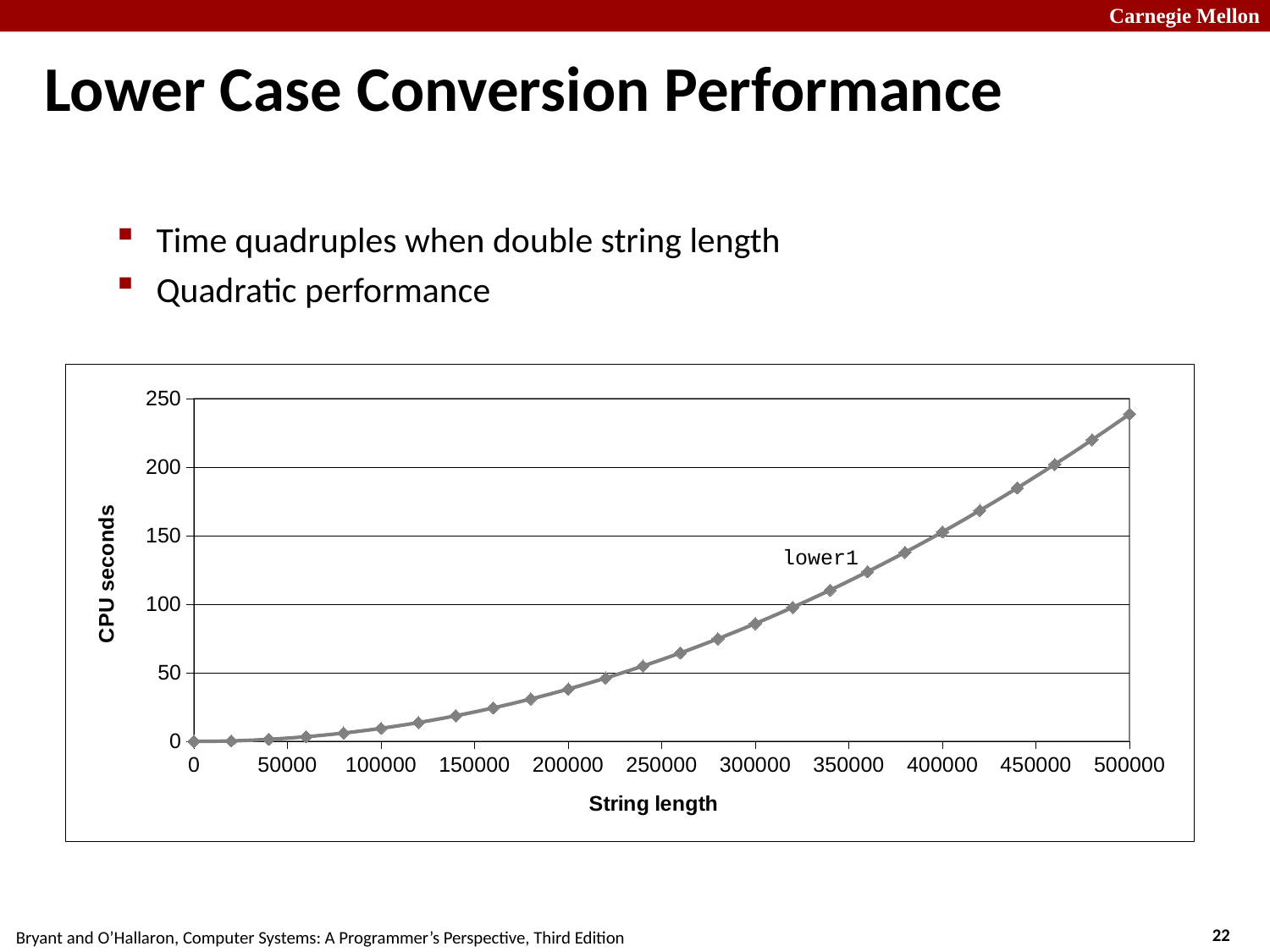
Do the CPU seconds rise or fall as string length increases? rise How many data points are plotted on the lower1 line? 26 Is the CPU seconds value at string length 500000 greater or less than 200? greater At which string length is the CPU seconds value highest? 500000 What is the name of the series plotted in the chart? lower1 Is the CPU seconds value at string length 200000 greater or less than 50? less What kind of chart is shown on the slide? line chart What is the label of the y axis? CPU seconds Is the CPU seconds value at string length 300000 greater or less than 100? less Which has a larger CPU seconds value: string length 100000 or string length 400000? 400000 How many series does the chart plot? 1 At which string length is the CPU seconds value lowest? 0